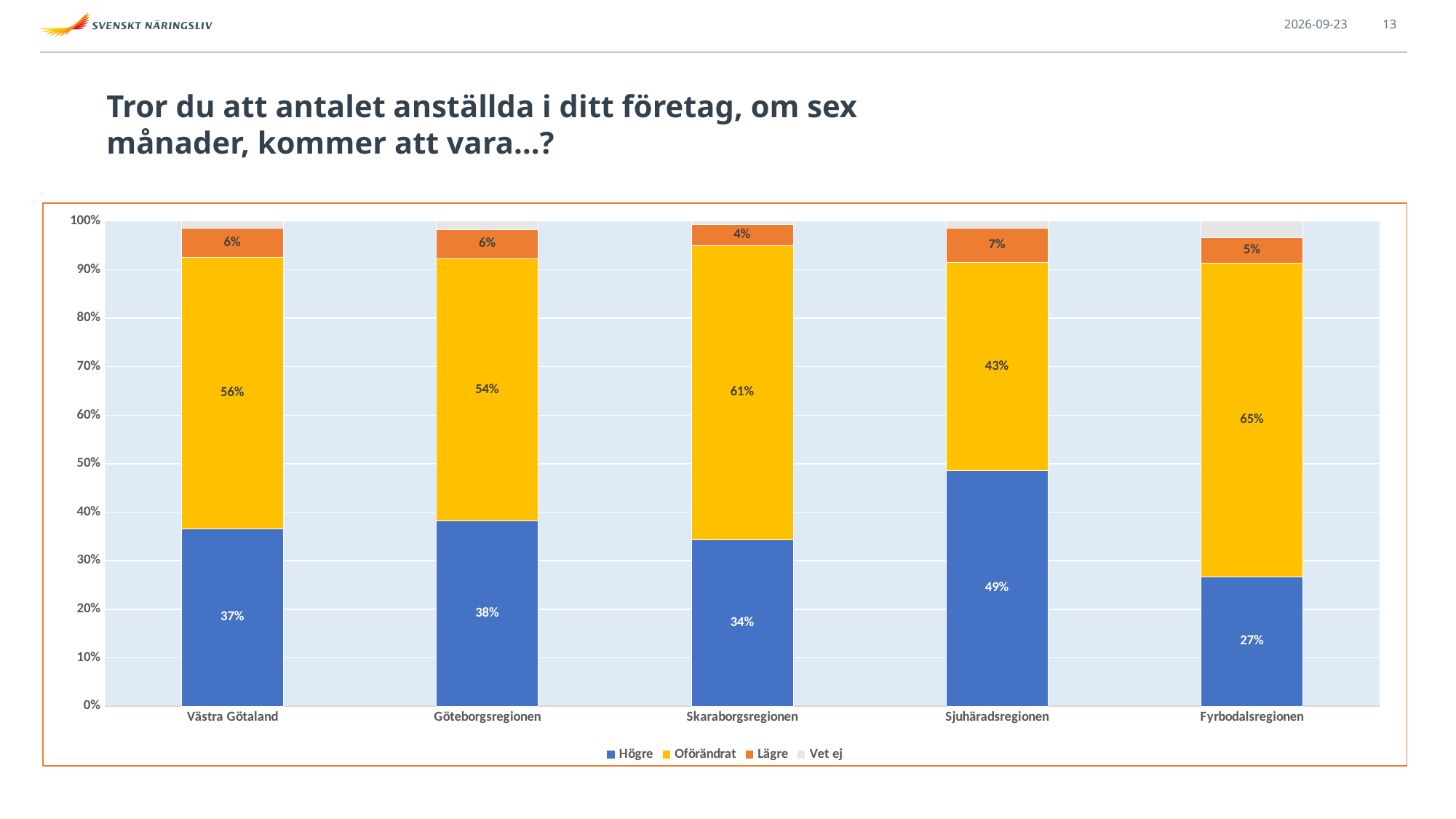
What is the difference between the Oförändrat values for Fyrbodalsregionen and Göteborgsregionen? 11% What is the Högre value for Sjuhäradsregionen? 49% Which region has the lowest Oförändrat value? Sjuhäradsregionen What kind of chart is shown on the slide? Stacked bar chart How many series does the legend list? 4 What is the Oförändrat value for Fyrbodalsregionen? 65% What is the Lägre value for Skaraborgsregionen? 4% Which is larger, the Högre value for Göteborgsregionen or for Skaraborgsregionen? Göteborgsregionen Which legend entry is shown in blue? Högre How many regions are shown on the x axis? 5 What is the Högre value for Västra Götaland? 37% Which region has the highest Högre value? Sjuhäradsregionen